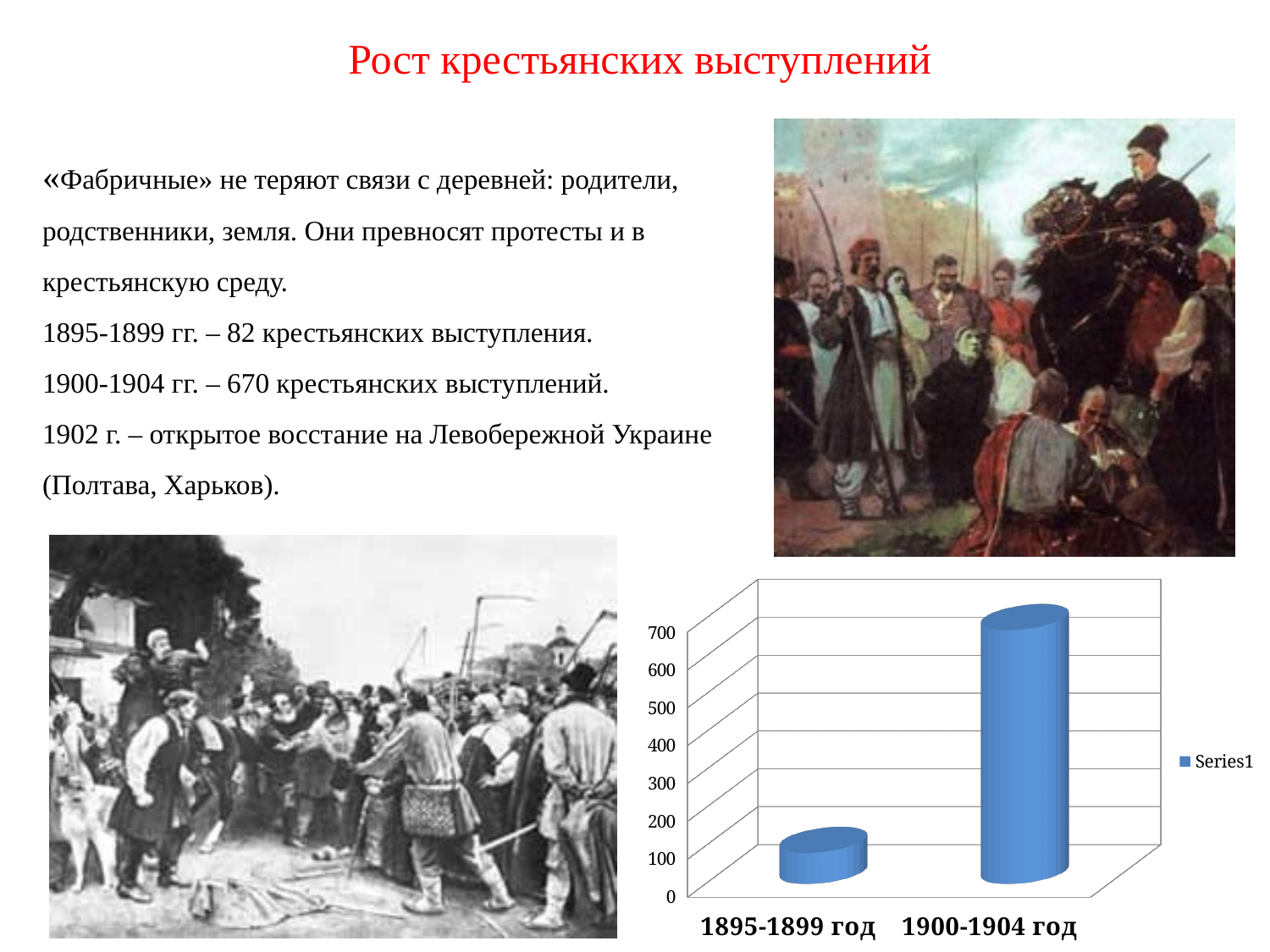
Which bar is taller: 1895-1899 год or 1900-1904 год? 1900-1904 год Is the value for 1895-1899 год greater or less than 200? less What is the highest tick value shown on the chart's vertical axis? 700 Is the value for 1900-1904 год greater or less than 600? greater What is the name of the series shown in the chart legend? Series1 Is the value for 1900-1904 год greater or less than 500? greater How many series does the chart legend list? 1 Which category has the lowest bar in the chart? 1895-1899 год Which category has the highest bar in the chart? 1900-1904 год What kind of chart is shown on the slide? bar chart Do the values rise or fall from 1895-1899 год to 1900-1904 год? rise How many categories are shown on the x axis of the chart? 2